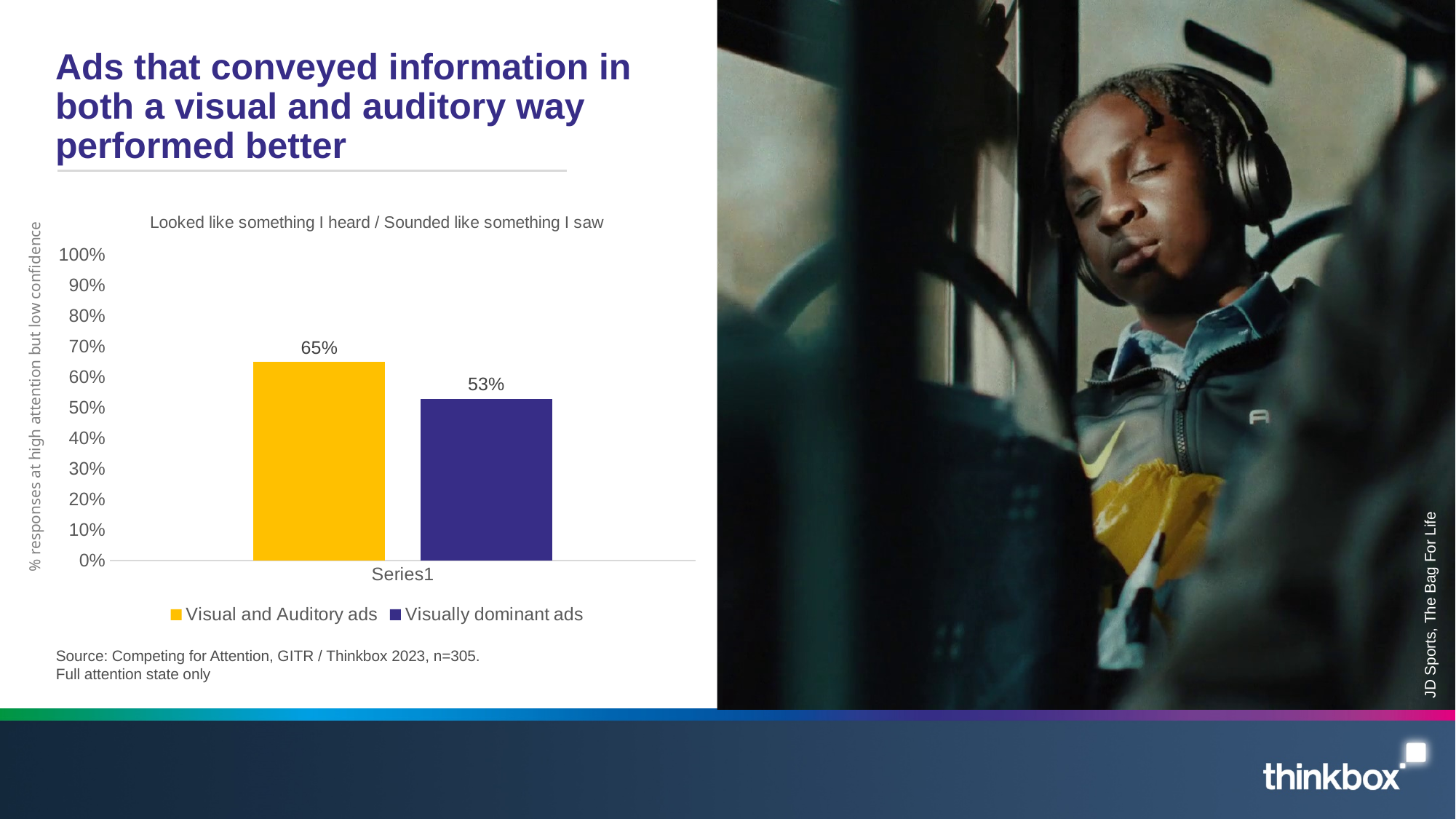
How many series does the legend list? 2 Which series has the lowest value? Visually dominant ads How many bars are plotted in the chart? 2 Is the value for Visually dominant ads greater or less than 60%? less What is the value for Visual and Auditory ads? 65% Which is larger, the value for Visual and Auditory ads or the value for Visually dominant ads? Visual and Auditory ads Is the value for Visual and Auditory ads greater or less than 60%? greater What is the difference between the values for Visual and Auditory ads and Visually dominant ads? 12% What kind of chart is shown on the slide? Bar chart What is the value for Visually dominant ads? 53% Which series has the highest value? Visual and Auditory ads What is the title of the chart? Looked like something I heard / Sounded like something I saw